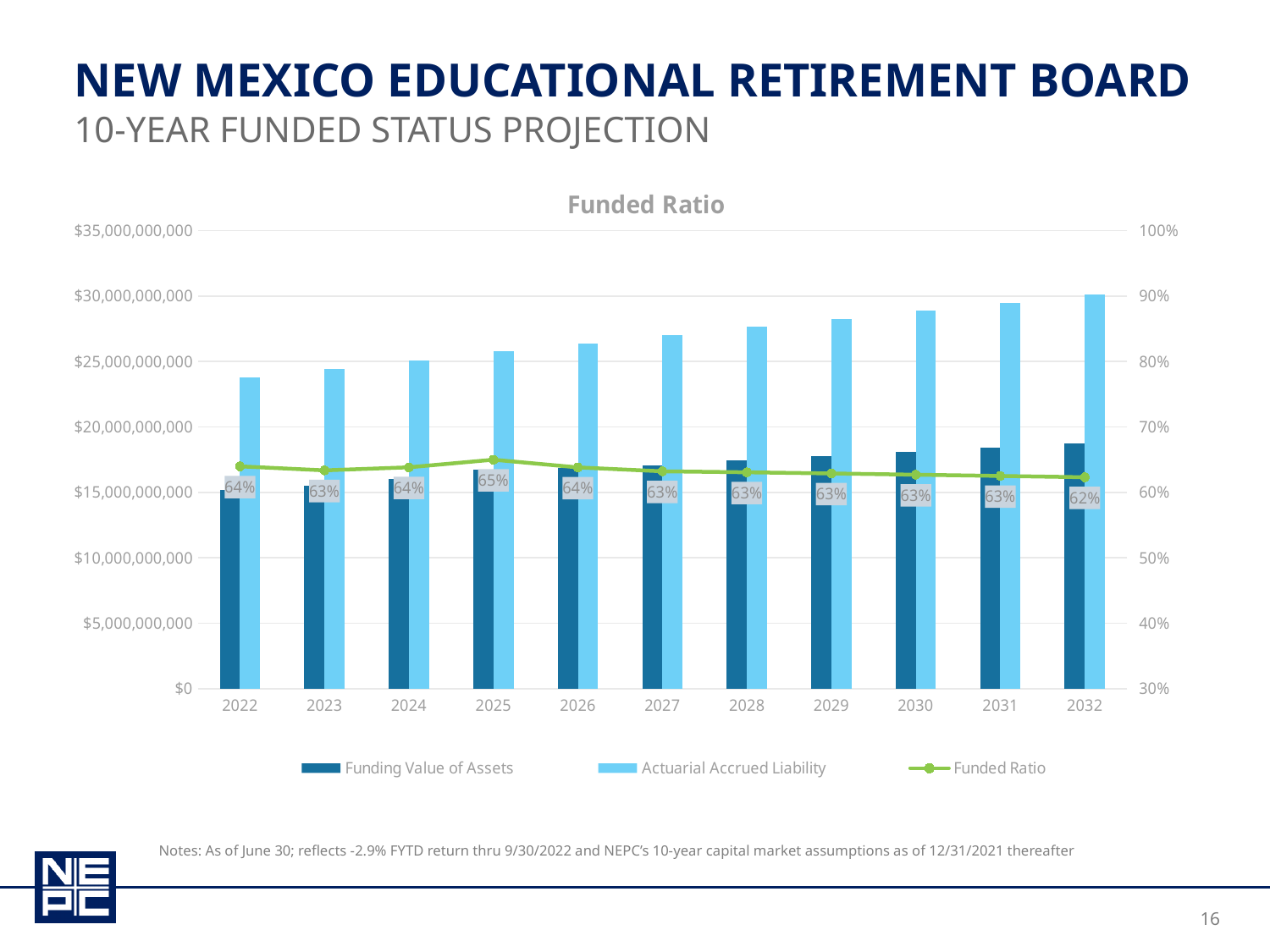
Is the Funding Value of Assets for 2032 greater or less than $20,000,000,000? less In 2032, which is larger: the Actuarial Accrued Liability or the Funding Value of Assets? Actuarial Accrued Liability What is the Funded Ratio shown for 2022? 64% What is the Funded Ratio shown for 2032? 62% Does the Actuarial Accrued Liability rise or fall from 2022 to 2032? rise In which year is the Funded Ratio highest? 2025 Is the Actuarial Accrued Liability for 2022 greater or less than $25,000,000,000? less How many years are shown on the x axis of the chart? 11 How many series does the chart legend list? 3 By how many percentage points does the Funded Ratio in 2025 exceed the Funded Ratio in 2032? 3 percentage points What is the Funded Ratio shown for 2025? 65% In which year is the Funded Ratio lowest? 2032